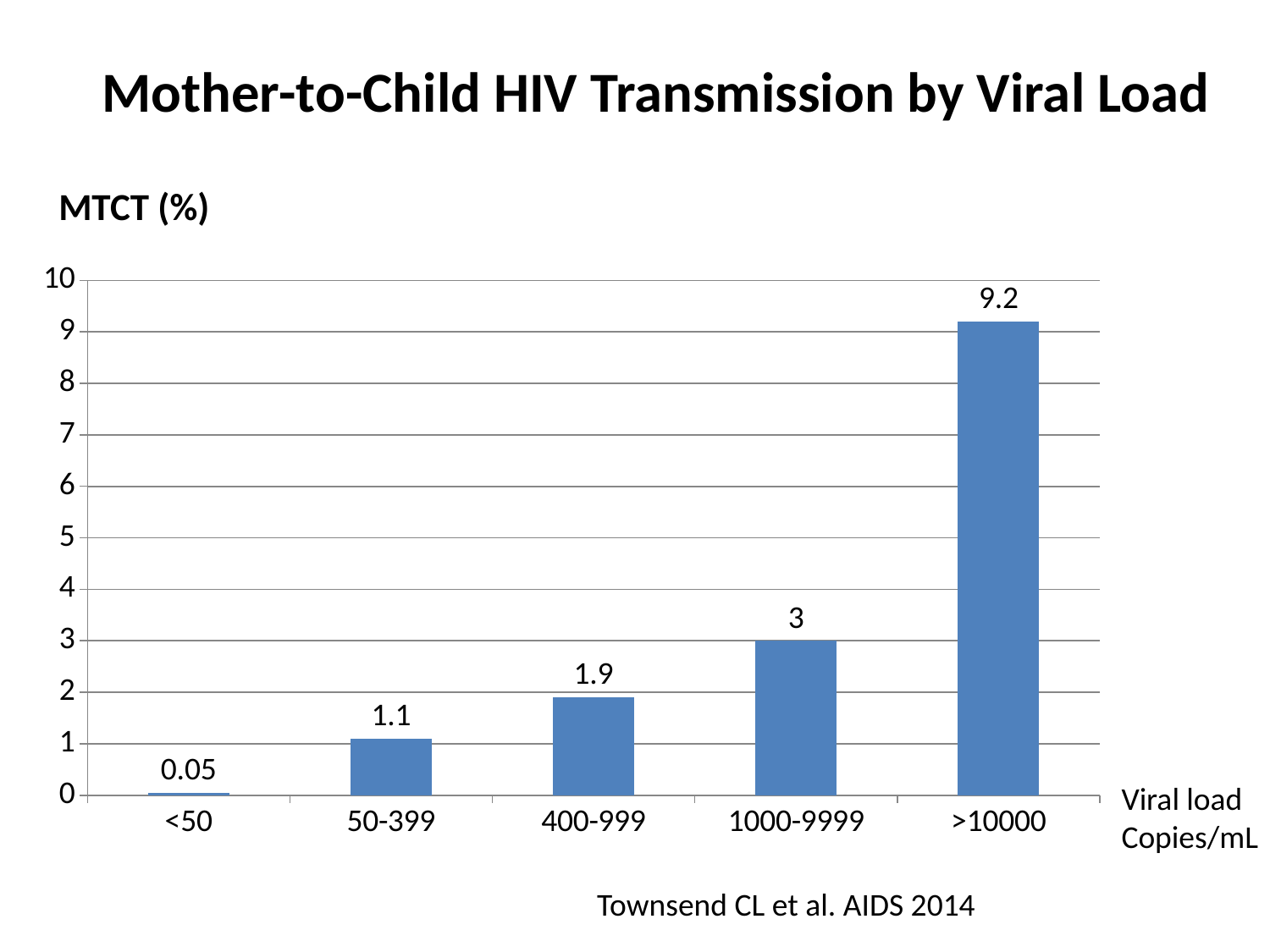
What is the difference in MTCT (%) between the >10000 and 1000-9999 categories? 6.2 What kind of chart is shown on the slide? Bar chart Do the MTCT (%) values rise or fall as viral load increases along the x axis? Rise What is the MTCT (%) value for the 400-999 viral load category? 1.9 Which has a higher MTCT (%): 50-399 or 400-999? 400-999 How many viral load categories are shown on the chart? 5 What is the MTCT (%) value for the >10000 viral load category? 9.2 Which viral load category has the highest MTCT (%)? >10000 Which viral load category has the lowest MTCT (%)? <50 Is the value for 1000-9999 greater or less than 5? less What is the MTCT (%) value for the 1000-9999 viral load category? 3 What is the MTCT (%) value for the <50 viral load category? 0.05